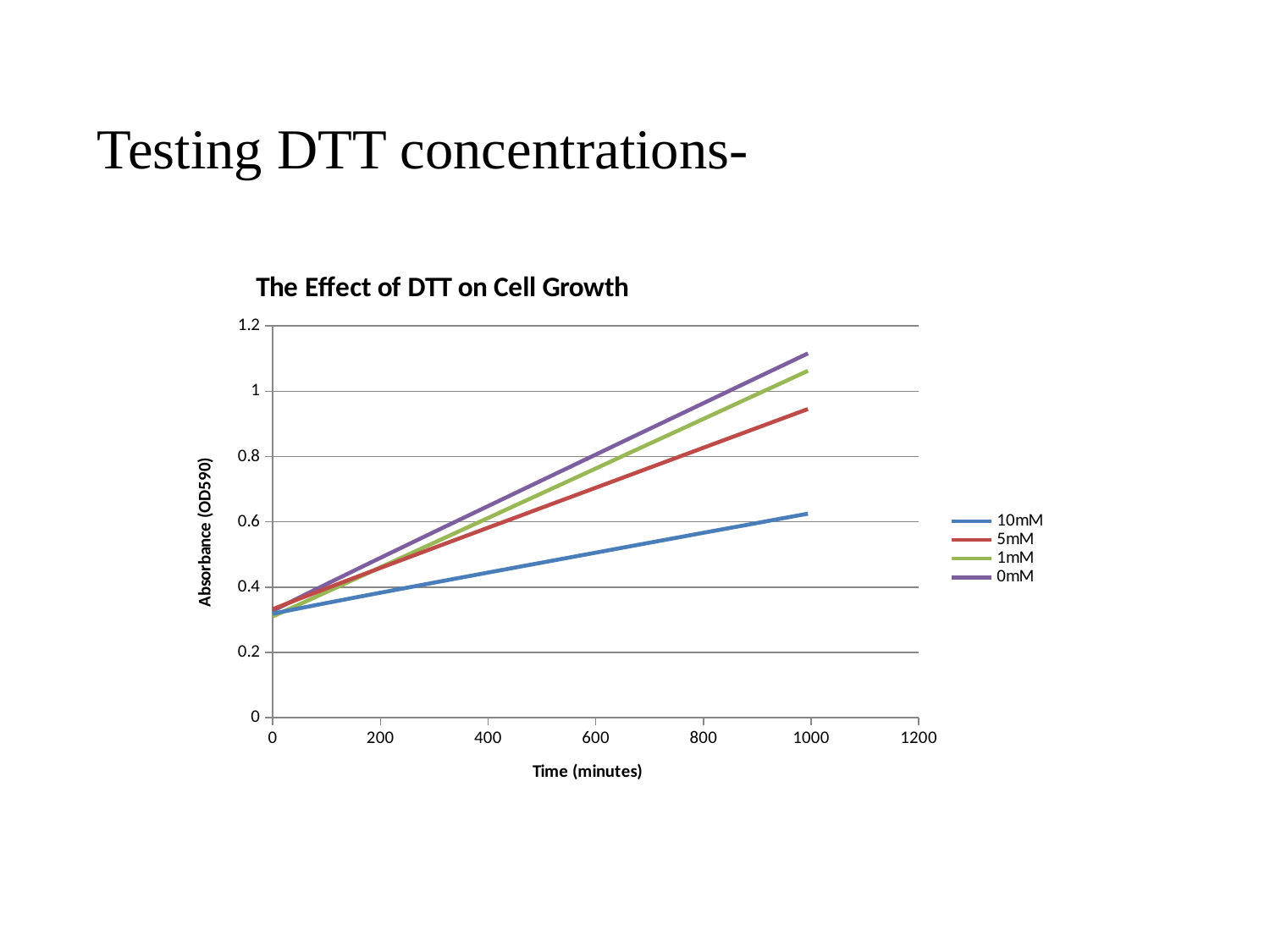
Which series has the highest absorbance at the end of the time period? 0mM At the end of the time period, which series has the larger absorbance, 10mM or 5mM? 5mM Does the absorbance for the 10mM series rise or fall as time increases? rise Is the final value for the 0mM series greater or less than 1? greater How many series does the legend list? 4 Is the final value for the 10mM series greater or less than 0.8? less What kind of chart is shown on the slide? line chart Which series has the lowest absorbance at the end of the time period? 10mM What is the title of the chart? The Effect of DTT on Cell Growth What is the label of the y axis? Absorbance (OD590) At the end of the time period, which series has the larger absorbance, 5mM or 1mM? 1mM Is the final value for the 5mM series greater or less than 0.8? greater